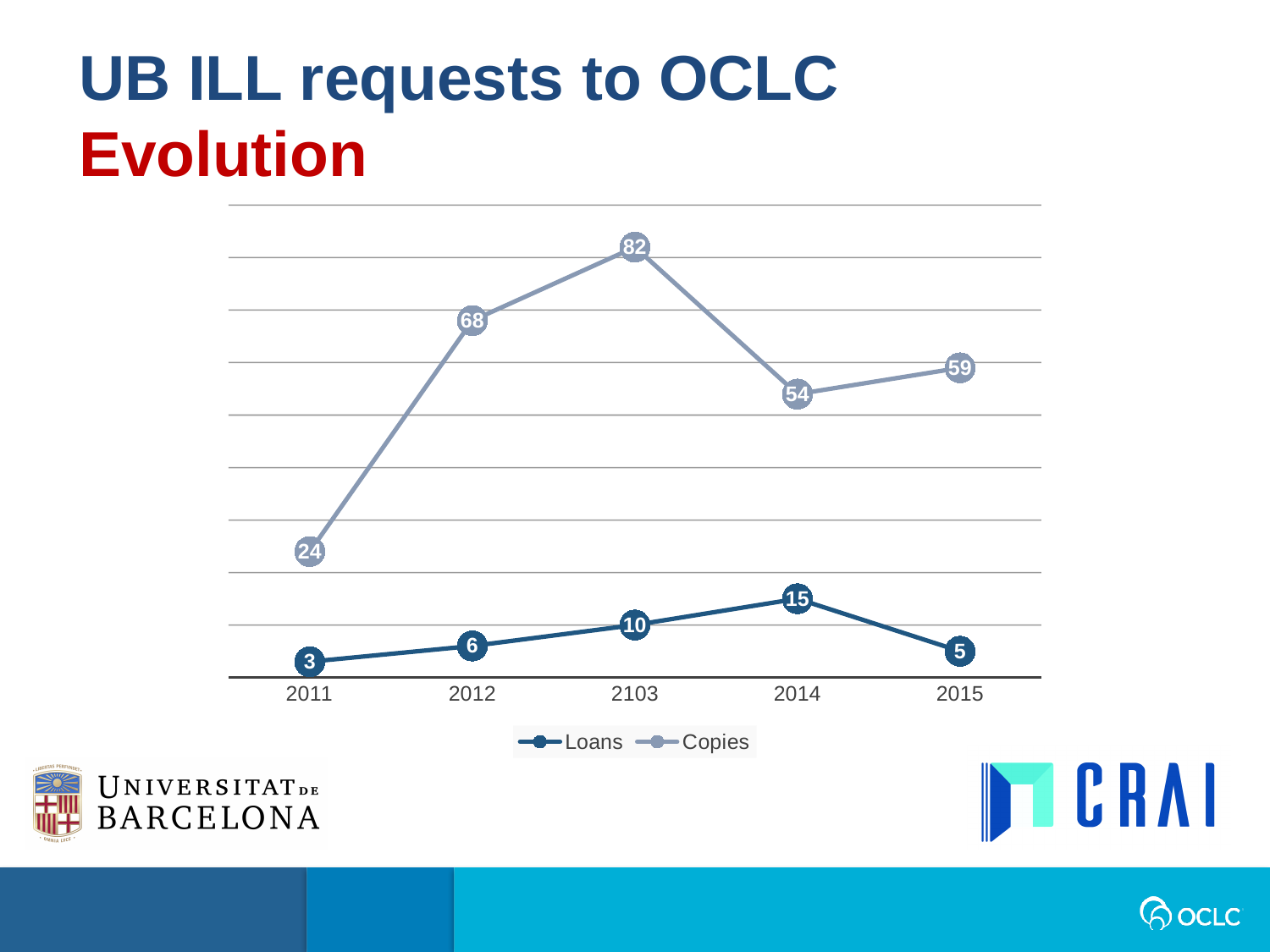
In which year is the Loans series lowest? 2011 Does the Copies series rise or fall between 2011 and 2012? Rise How many series does the legend list? 2 What is the value for Loans in 2014? 15 How many years are shown on the x axis? 5 What is the value for Copies in 2012? 68 What kind of chart is shown on the slide? Line chart Which is larger, Loans in 2012 or Loans in 2015? Loans in 2012 In which year is the Copies series highest? 2103 What is the difference between Copies and Loans in 2014? 39 What is the value for Copies in 2015? 59 What are the two series named in the legend? Loans and Copies